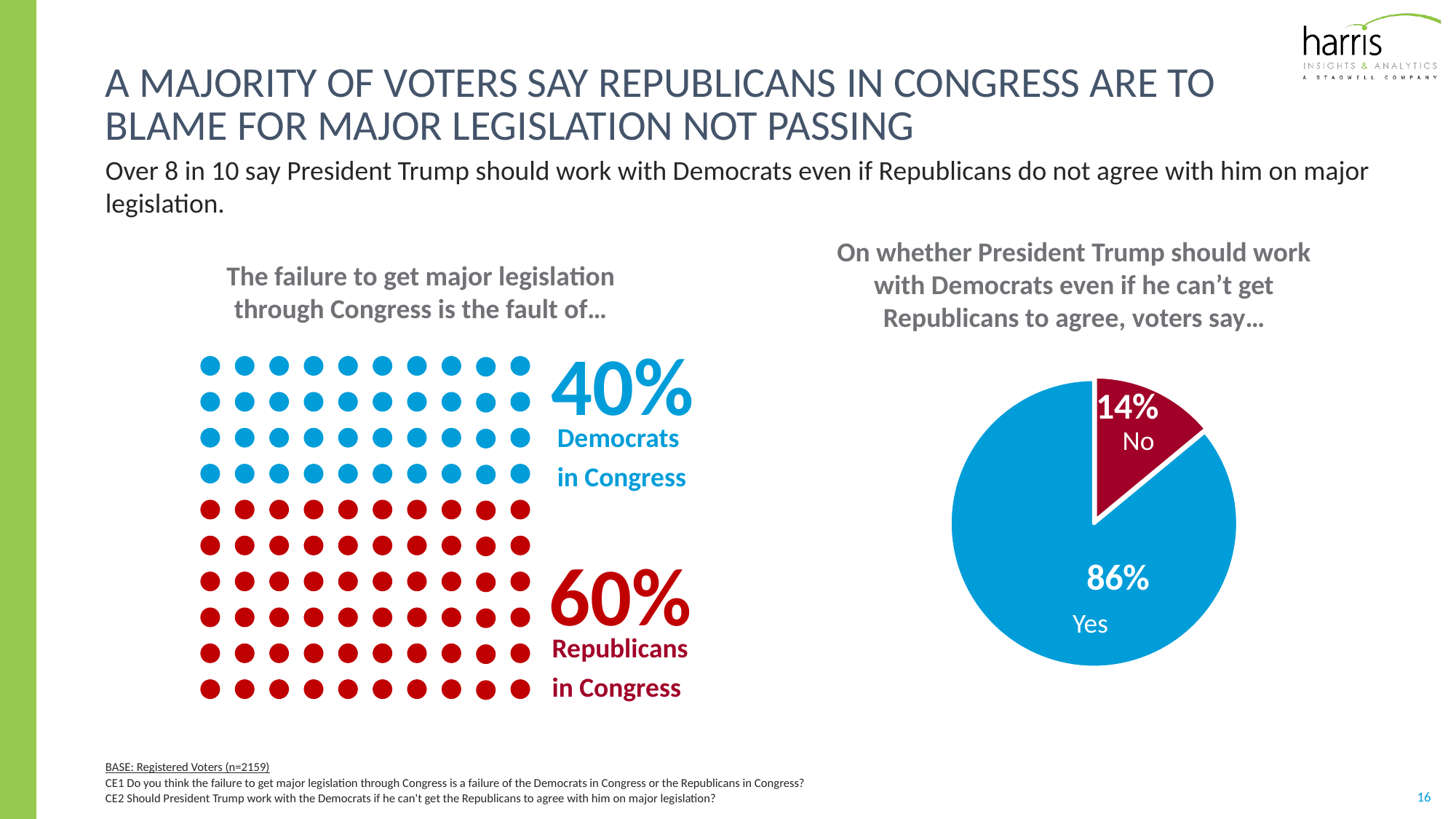
In the pie chart on the right, what percentage of voters say No? 14% In the pie chart on the right, which response has the larger share, Yes or No? Yes What kind of chart is shown on the right side of the slide? Pie chart In the pie chart on the right, how many slices are there? 2 In the left chart, what percentage of voters blame Democrats in Congress for the failure to get major legislation through Congress? 40% In the left chart, which group is blamed by more voters, Democrats in Congress or Republicans in Congress? Republicans in Congress In the left chart, what is the difference in percentage points between the share blaming Republicans in Congress and the share blaming Democrats in Congress? 20 In the pie chart on the right, what percentage of voters say Yes? 86% In the pie chart on the right, what colour is the Yes slice? Blue In the pie chart on the right, what is the difference in percentage points between the Yes and No shares? 72 In the left chart, what colour are the dots representing Republicans in Congress? Red In the left chart, what percentage of voters blame Republicans in Congress? 60%